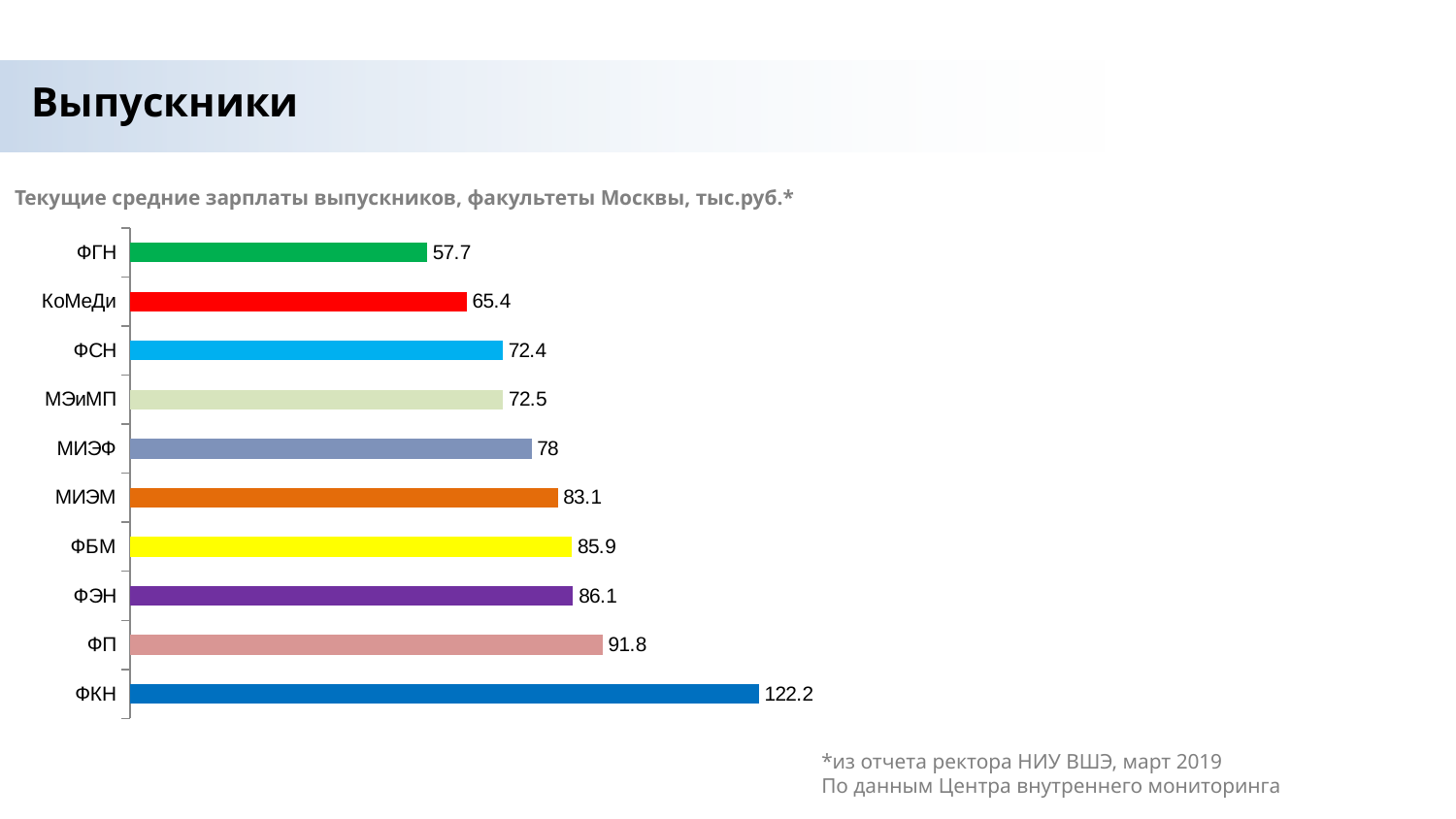
Which faculty has the lowest value? ФГН What kind of chart is shown on the slide? Bar chart What is the value for ФКН? 122.2 What is the difference between the values for ФБМ and ФГН? 28.2 Which is larger, the value for МИЭФ or the value for ФСН? МИЭФ What is the value for МИЭМ? 83.1 What is the difference between the values for ФКН and ФП? 30.4 Which faculty has the highest value? ФКН What is the title of the chart? Текущие средние зарплаты выпускников, факультеты Москвы, тыс.руб.* What is the value for КоМеДи? 65.4 What colour is the bar for ФКН? Blue How many faculties are shown in the chart? 10